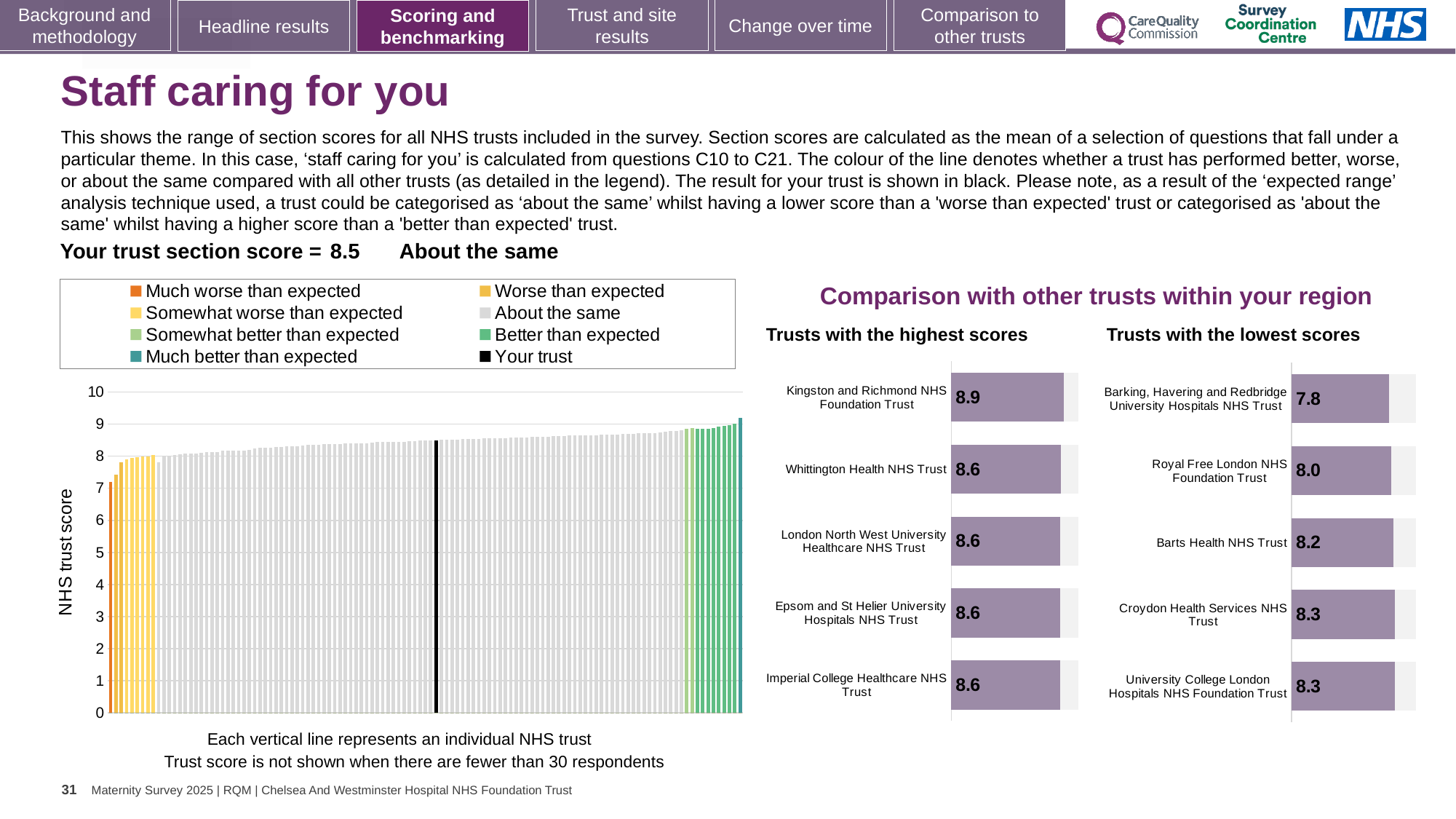
In the 'Trusts with the highest scores' chart, what is the score for Kingston and Richmond NHS Foundation Trust? 8.9 How many entries does the legend of the NHS trust score chart list? 8 What kind of chart is the 'NHS trust score' chart on the left? Bar chart How many trusts are listed in the 'Trusts with the highest scores' chart? 5 In the 'NHS trust score' chart, do the bar heights rise or fall from left to right? Rise In the 'Trusts with the lowest scores' chart, what is the score for Barking, Havering and Redbridge University Hospitals NHS Trust? 7.8 In the 'Trusts with the lowest scores' chart, which trust has the lowest score? Barking, Havering and Redbridge University Hospitals NHS Trust In the 'Trusts with the lowest scores' chart, what is the score for Barts Health NHS Trust? 8.2 In the 'Trusts with the highest scores' chart, which trust has the highest score? Kingston and Richmond NHS Foundation Trust In the 'Trusts with the lowest scores' chart, which is larger: the score for Royal Free London NHS Foundation Trust or the score for Barts Health NHS Trust? Barts Health NHS Trust What is the difference between the score for Kingston and Richmond NHS Foundation Trust in the highest scores chart and the score for Barking, Havering and Redbridge University Hospitals NHS Trust in the lowest scores chart? 1.1 In the 'NHS trust score' chart, is the value of the black 'Your trust' bar greater or less than 8? greater